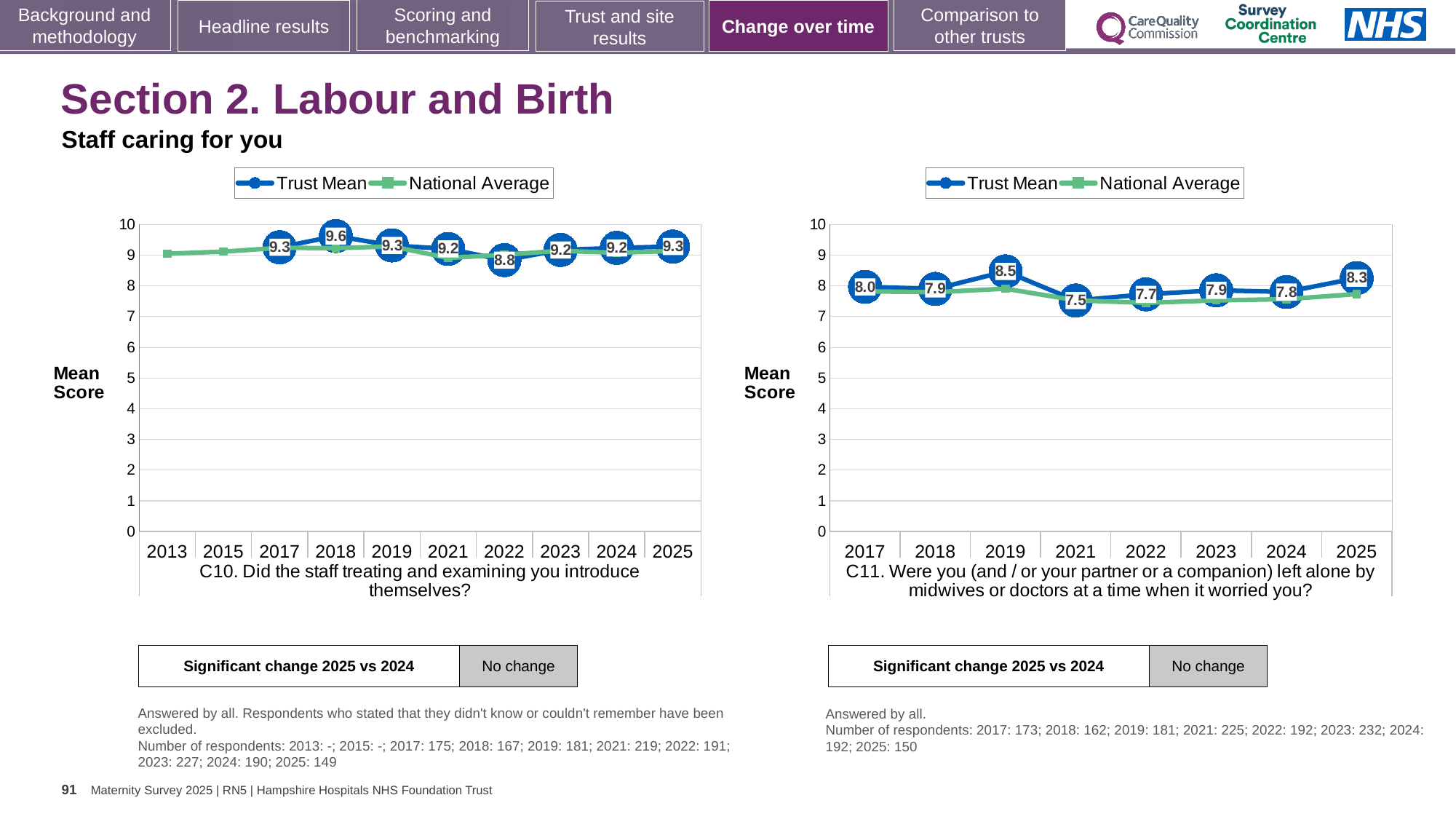
On the right chart (C11), in which year is the Trust Mean lowest? 2021 On the left chart (C10), in which year is the Trust Mean lowest? 2022 On the right chart (C11), what is the Trust Mean for 2019? 8.5 On the left chart (C10), in which year is the Trust Mean highest? 2018 On the left chart (C10), what is the Trust Mean for 2018? 9.6 On the right chart (C11), is the Trust Mean for 2024 higher or lower than for 2025? lower On the right chart (C11), what is the Trust Mean for 2025? 8.3 What kind of chart is the right chart (C11)? line chart On the left chart (C10), what is the difference between the Trust Mean in 2018 and in 2022? 0.8 On the left chart (C10), how many years are shown on the x axis? 10 On the left chart (C10), what is the Trust Mean for 2022? 8.8 On the right chart (C11), how many series does the legend list? 2